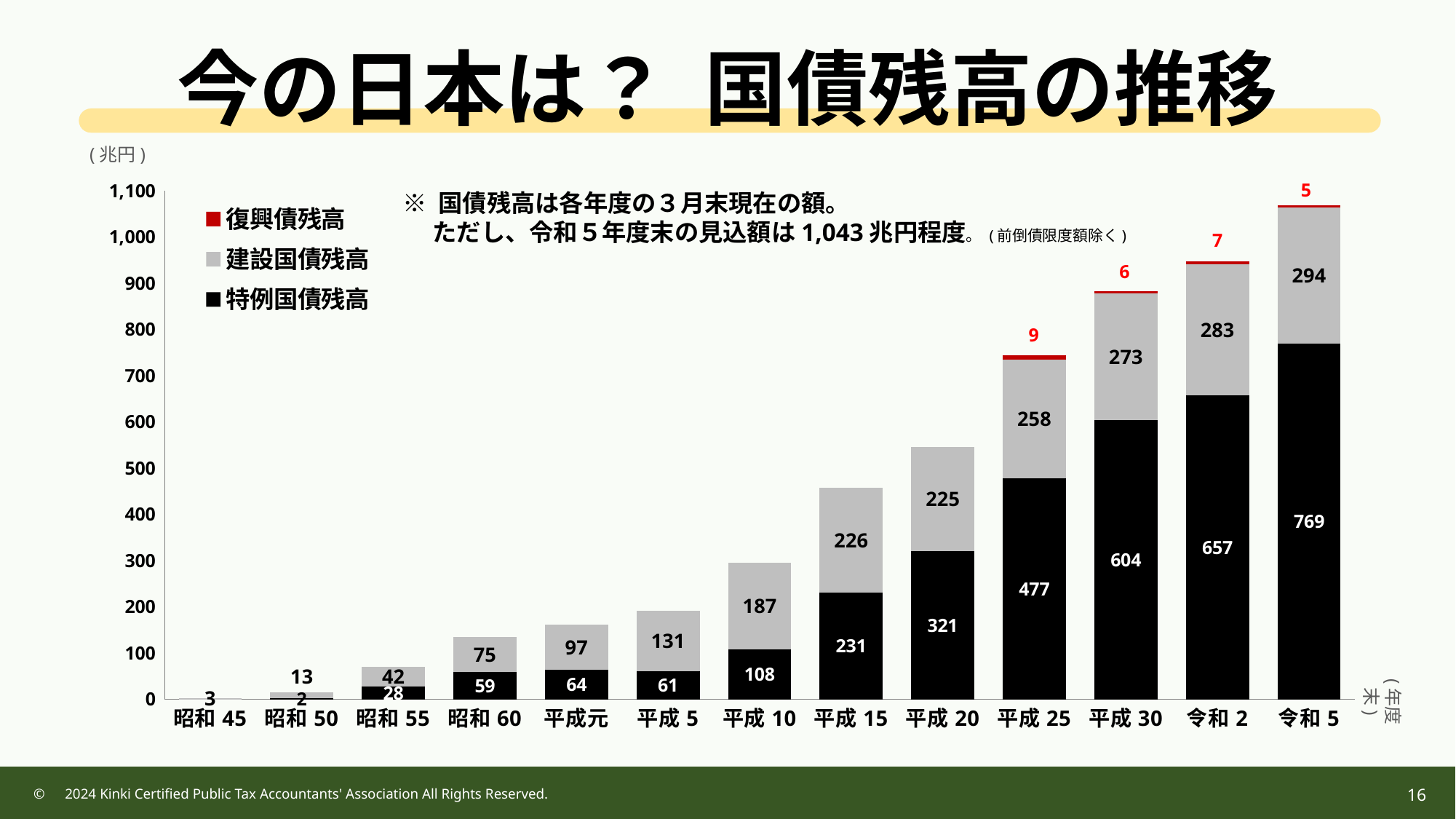
Which fiscal year has the highest 特例国債残高? 令和5 What type of chart is shown on the slide? Stacked bar chart What is the total of the stacked bar for 平成30? 883 How many fiscal-year categories are shown on the x axis? 13 What is the value of 建設国債残高 for 平成20? 225 What is the value of 特例国債残高 for 令和5? 769 What is the value of 復興債残高 for 平成25? 9 What is the difference between 特例国債残高 for 令和5 and 令和2? 112 How many series does the legend list? 3 Do the total bond balances rise or fall from 昭和45 to 令和5? Rise What is the total of the stacked bar for 令和5? 1,068 Which is larger for 平成15: 建設国債残高 or 特例国債残高? 特例国債残高